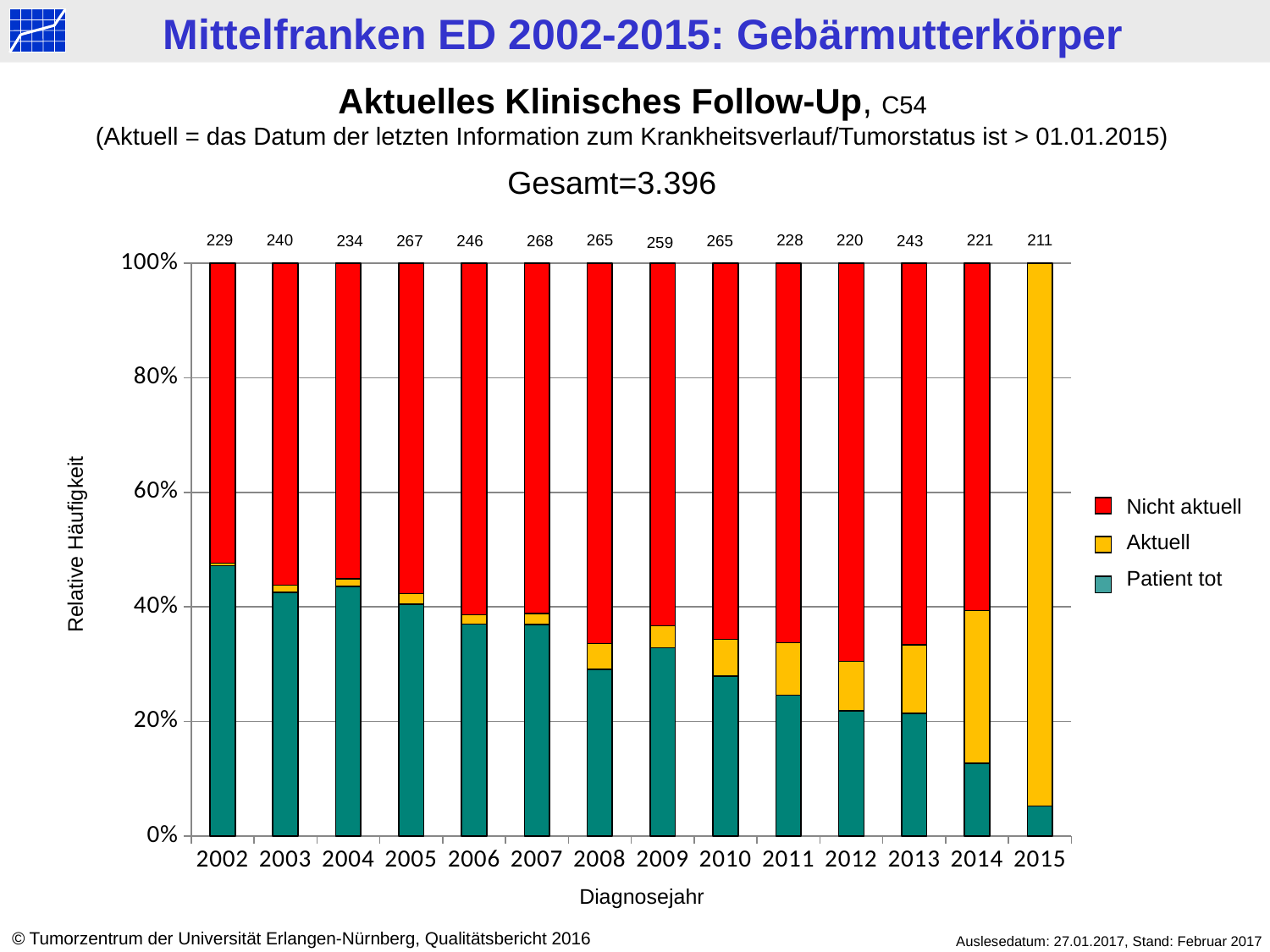
What kind of chart is shown on the slide? Stacked bar chart Which diagnosis year has the lowest number printed above its bar? 2015 What number is printed above the bar for 2007? 268 What number is printed above the bar for 2011? 228 Is the 'Patient tot' share for 2002 greater or less than 40%? greater Which diagnosis year has the highest number printed above its bar? 2007 What is the difference between the numbers printed above the bars for 2002 and 2015? 18 Is the 'Patient tot' share for 2014 greater or less than 20%? less Which year has the larger number printed above its bar, 2003 or 2004? 2003 What number is printed above the bar for 2015? 211 How many series does the legend list? 3 How many diagnosis years are shown on the x axis? 14